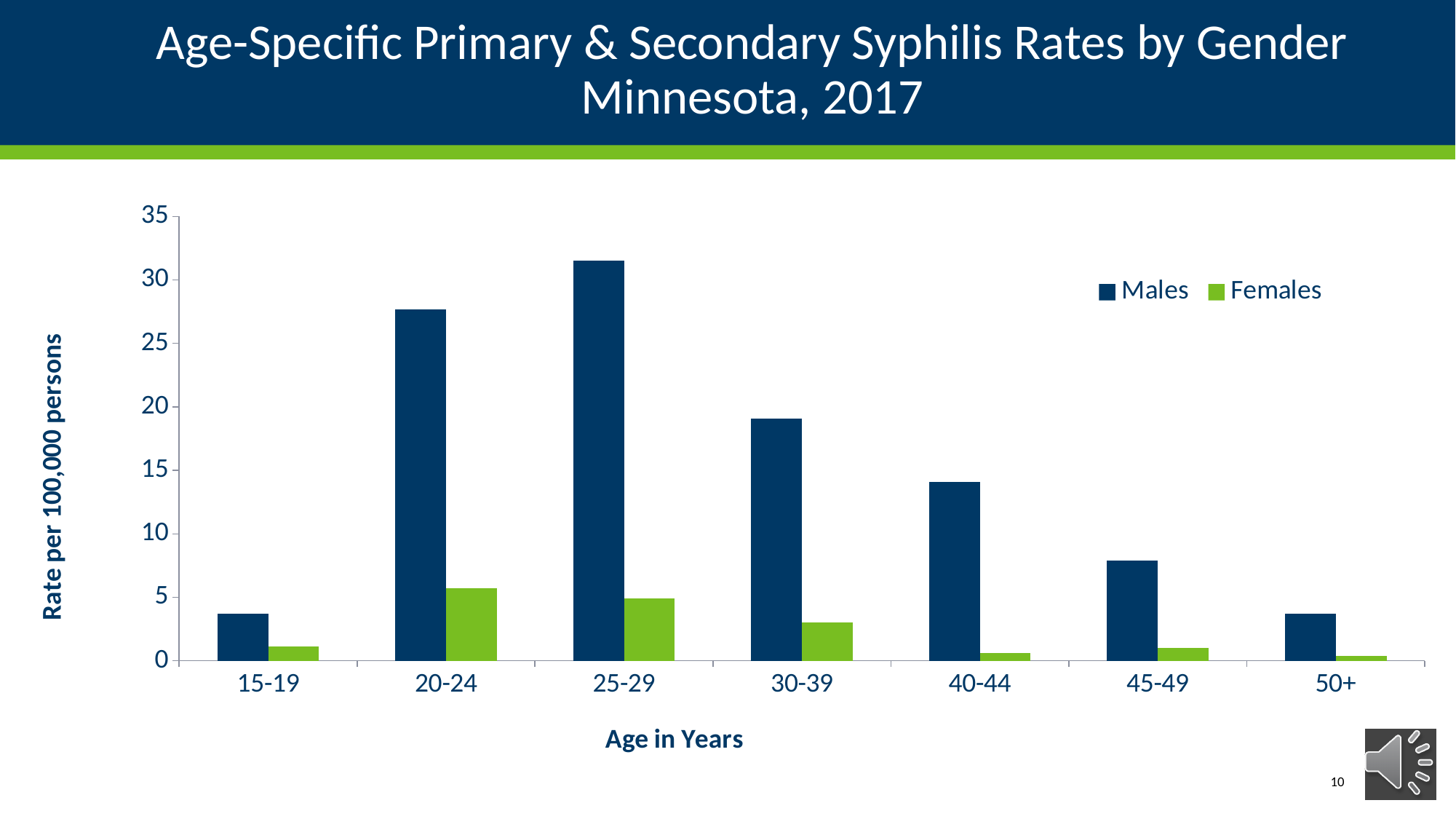
How many age groups are shown on the x axis? 7 What is the label of the y axis? Rate per 100,000 persons Is the Males rate for the 30-39 age group greater or less than 20? less Is the Males rate for the 20-24 age group greater or less than 25? greater Is the Males rate for the 25-29 age group greater or less than 30? greater Do the Males rates rise or fall from the 25-29 age group to the 50+ age group? fall What kind of chart is shown on the slide? bar chart How many series does the legend list? 2 Which age group has the highest rate for Females? 20-24 Which is larger for the 40-44 age group, the Males rate or the Females rate? Males Which age group has the highest rate for Males? 25-29